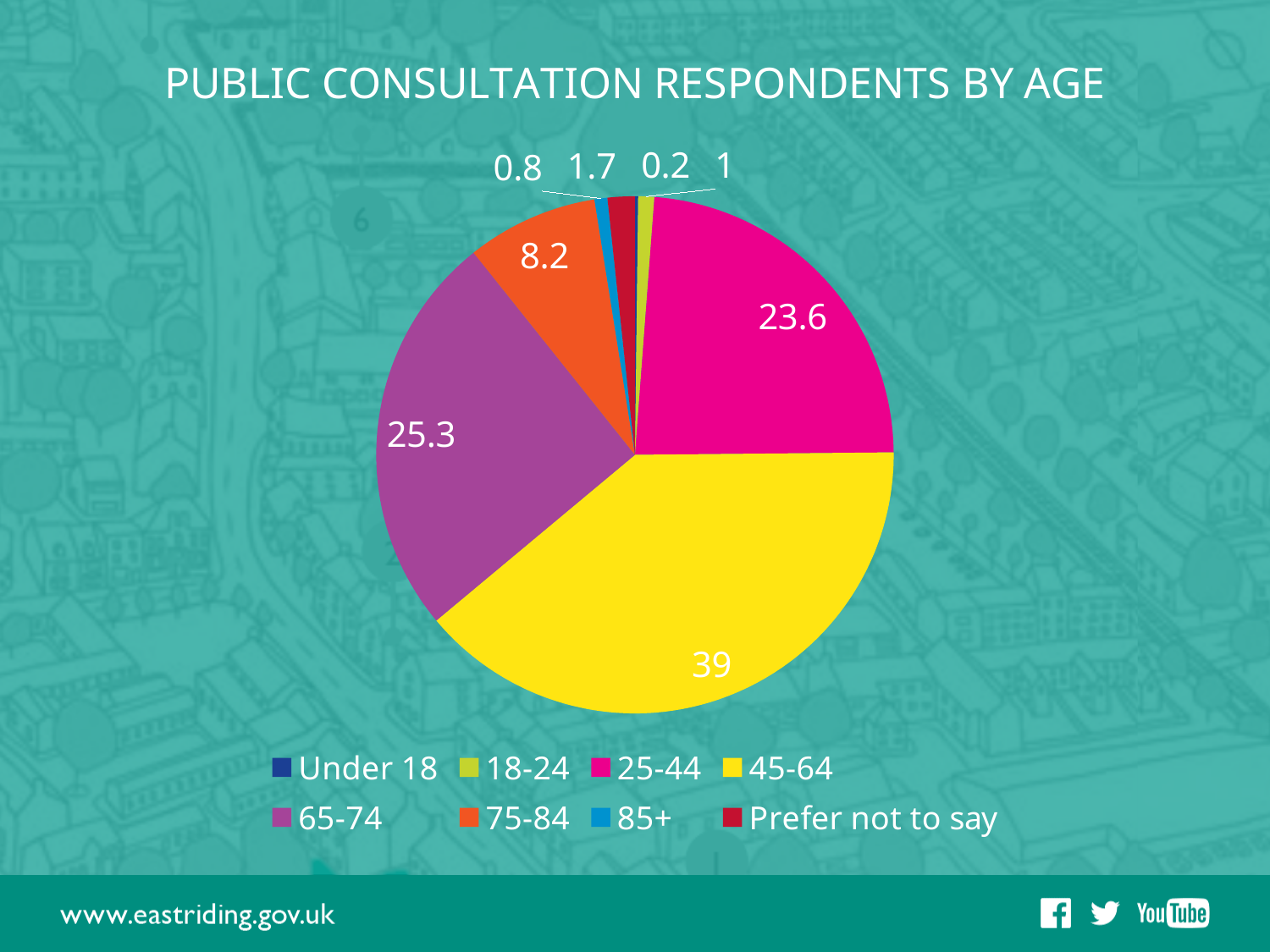
How many categories does the legend list? 8 What is the value shown for the 75-84 age group? 8.2 What is the value shown for the 'Prefer not to say' category? 1.7 What kind of chart is shown on the slide? Pie chart Which age group has the largest slice of the pie? 45-64 What is the difference between the values for the 45-64 and 65-74 age groups? 13.7 What is the value shown for the 45-64 age group? 39 What is the value shown for the 65-74 age group? 25.3 What is the value shown for the 25-44 age group? 23.6 Which category has the smallest slice of the pie? Under 18 Which is larger, the value for 65-74 or the value for 25-44? 65-74 What is the title of the chart? PUBLIC CONSULTATION RESPONDENTS BY AGE